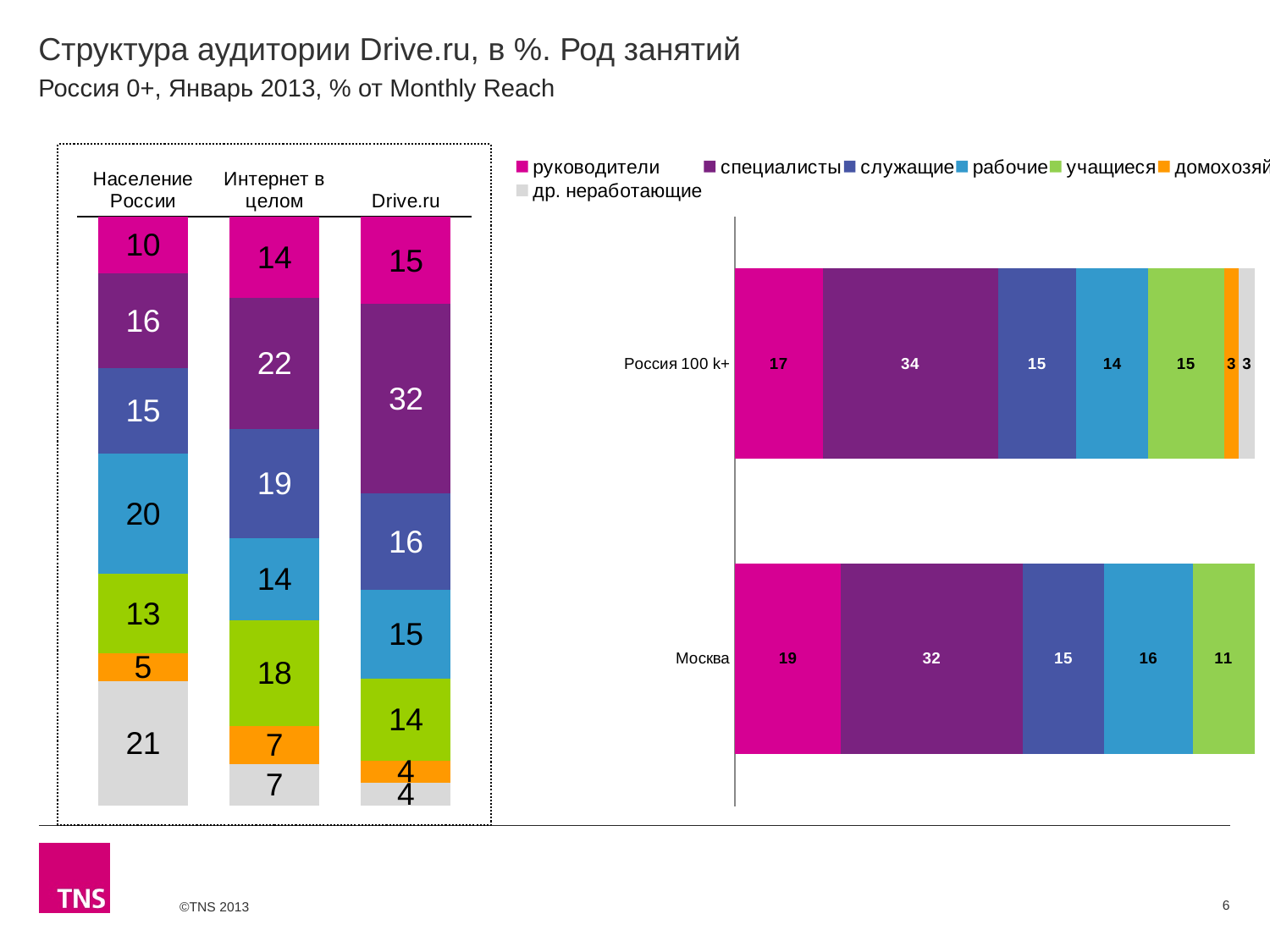
How many series does the legend list? 7 In the right chart, which is larger: рабочие for Москва or рабочие for Россия 100 k+? Москва In the left chart, which segment is the smallest in the Население России bar? домохозяйки In the right chart, what is the value for специалисты for Россия 100 k+? 34 In the left chart, which segment is the largest in the Drive.ru bar? специалисты In the left chart, what is the difference between the специалисты values for Drive.ru and Население России? 16 In the left chart, what is the value for др. неработающие in the Население России bar? 21 In the right chart, what is the value for руководители for Москва? 19 How many categories are shown in the right chart? 2 What kind of chart is the right chart? stacked bar chart In the left chart, what is the value for специалисты in the Drive.ru bar? 32 In the left chart, what is the value for учащиеся in the Интернет в целом bar? 18